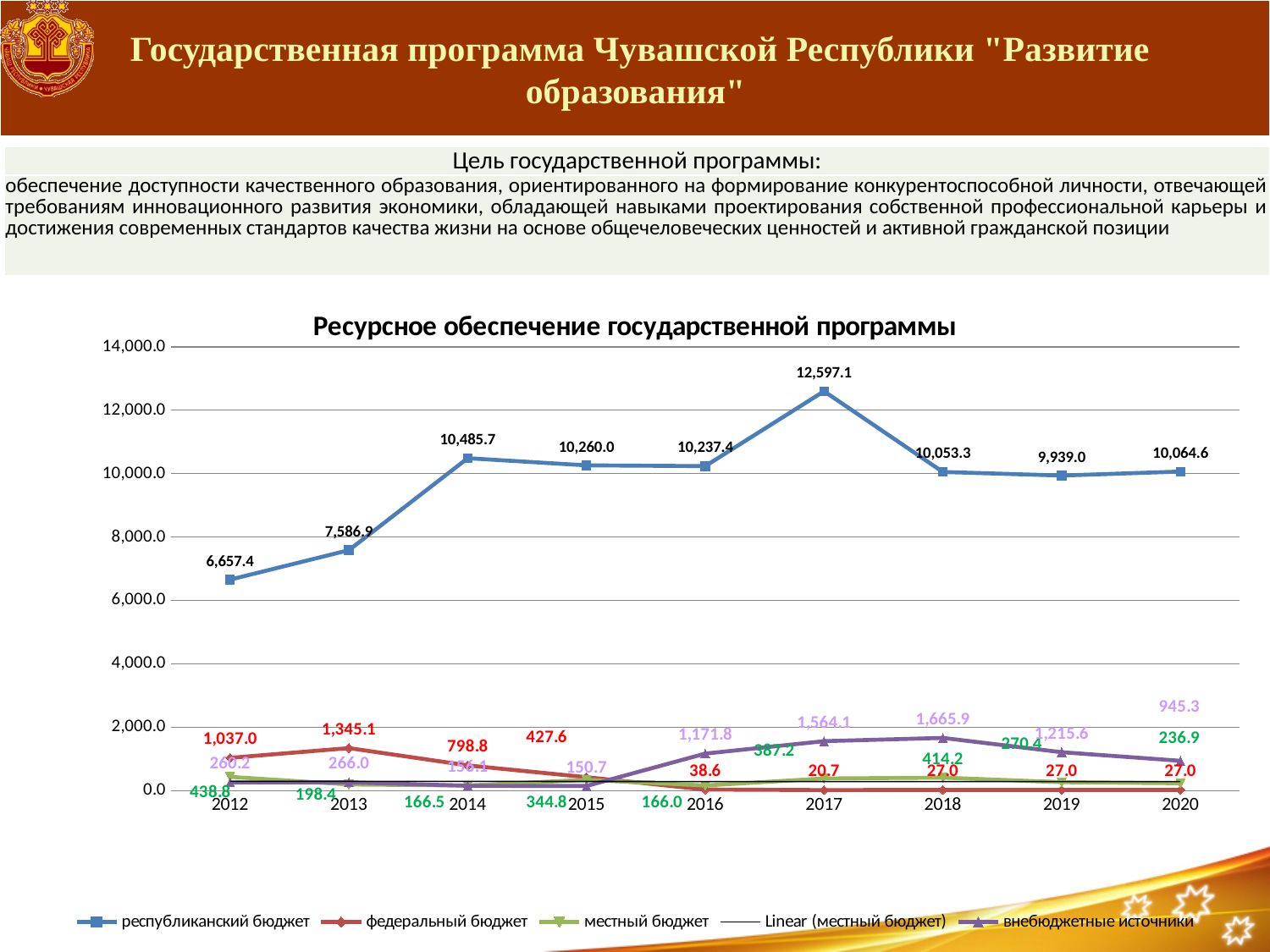
Which is larger in 2020: внебюджетные источники or федеральный бюджет? внебюджетные источники What is the difference between республиканский бюджет in 2017 and in 2018? 2,543.8 What is the value for федеральный бюджет in 2013? 1,345.1 In which year is республиканский бюджет lowest? 2012 What is the value for республиканский бюджет in 2012? 6,657.4 What type of chart is shown on the slide? line chart What is the value for республиканский бюджет in 2017? 12,597.1 How many years are shown on the x axis? 9 Is the value for республиканский бюджет in 2014 greater or less than 10,000.0? greater In which year is республиканский бюджет highest? 2017 What is the value for внебюджетные источники in 2018? 1,665.9 How many entries does the legend list? 5